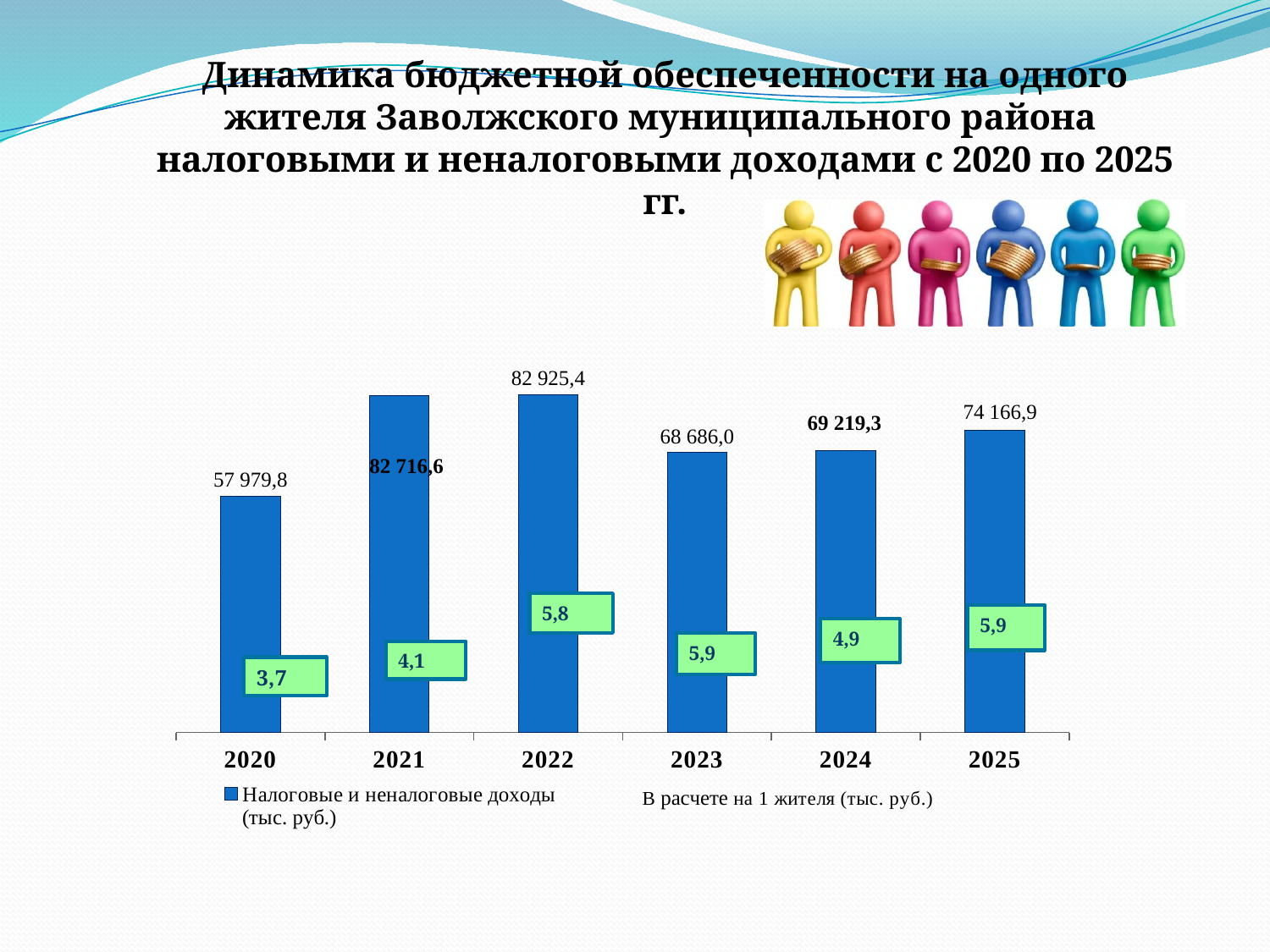
How many series does the legend list? 1 What is the value of tax and non-tax revenues (Налоговые и неналоговые доходы) for 2022? 82 925,4 What is the per-resident value (В расчете на 1 жителя) shown for 2021? 4,1 Which year has the larger tax and non-tax revenues, 2023 or 2025? 2025 How many years are shown on the x axis of the chart? 6 Which year has the highest value of tax and non-tax revenues? 2022 What type of chart is shown on the slide? Bar chart What is the per-resident value (В расчете на 1 жителя) shown for 2024? 4,9 Which year has the lowest per-resident value (В расчете на 1 жителя)? 2020 What is the value of tax and non-tax revenues (Налоговые и неналоговые доходы) for 2020? 57 979,8 Which year has the lowest value of tax and non-tax revenues? 2020 What is the difference between the tax and non-tax revenues for 2025 and 2024? 4 947,6